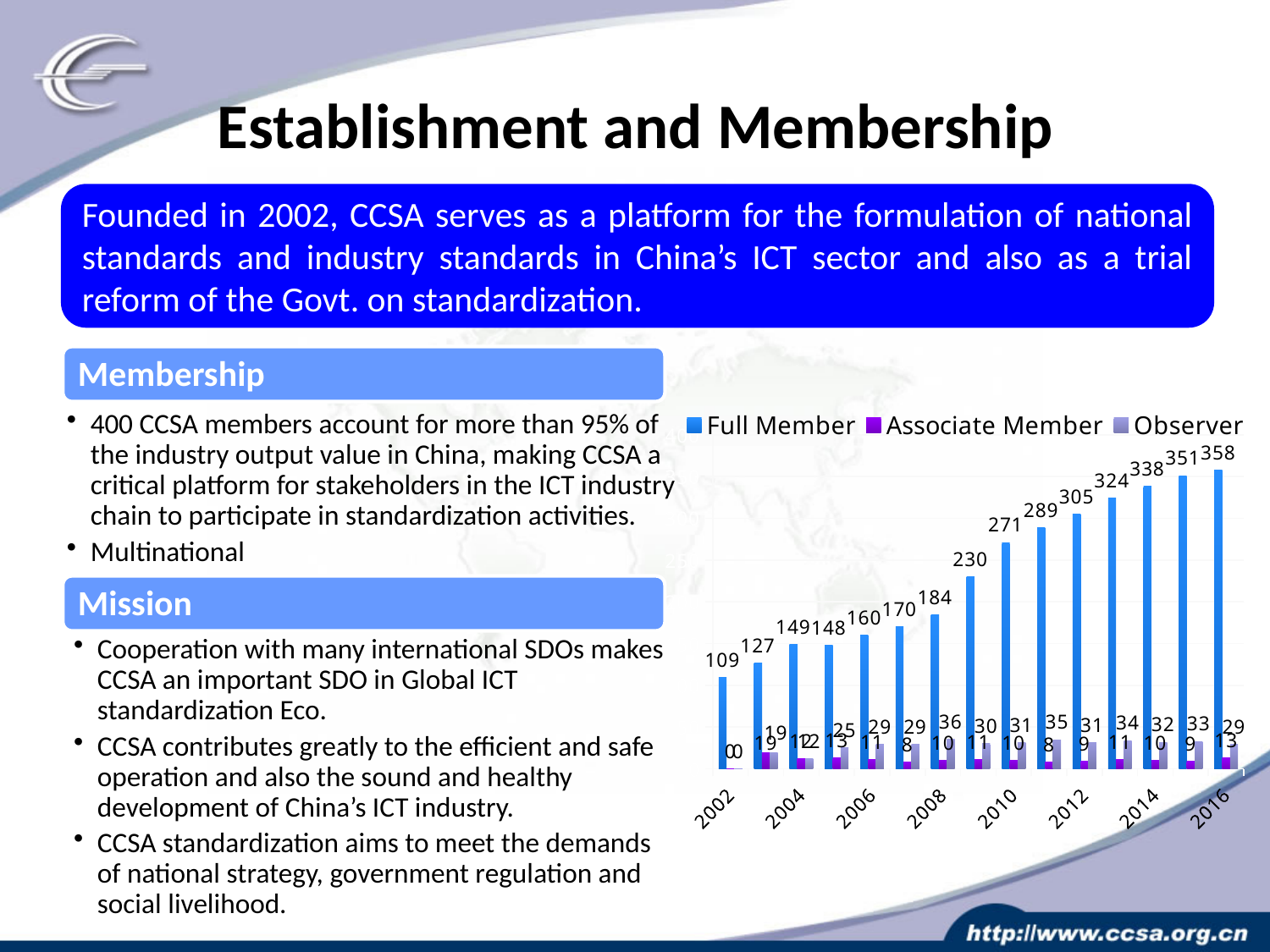
Which year has the highest Full Member value? 2016 What kind of chart is shown on the slide? bar chart Which is larger in 2016, the Observer value or the Associate Member value? Observer What is the Full Member value for 2010? 271 What is the Full Member value for 2016? 358 How many series does the chart legend list? 3 What are the three series named in the chart legend? Full Member, Associate Member, Observer Does the Full Member series generally rise or fall from 2002 to 2016? rise Which year has the lowest Full Member value? 2002 What is the Full Member value for 2002? 109 Is the Full Member value for 2009 greater or less than 200? greater What is the difference between the Full Member values for 2016 and 2002? 249